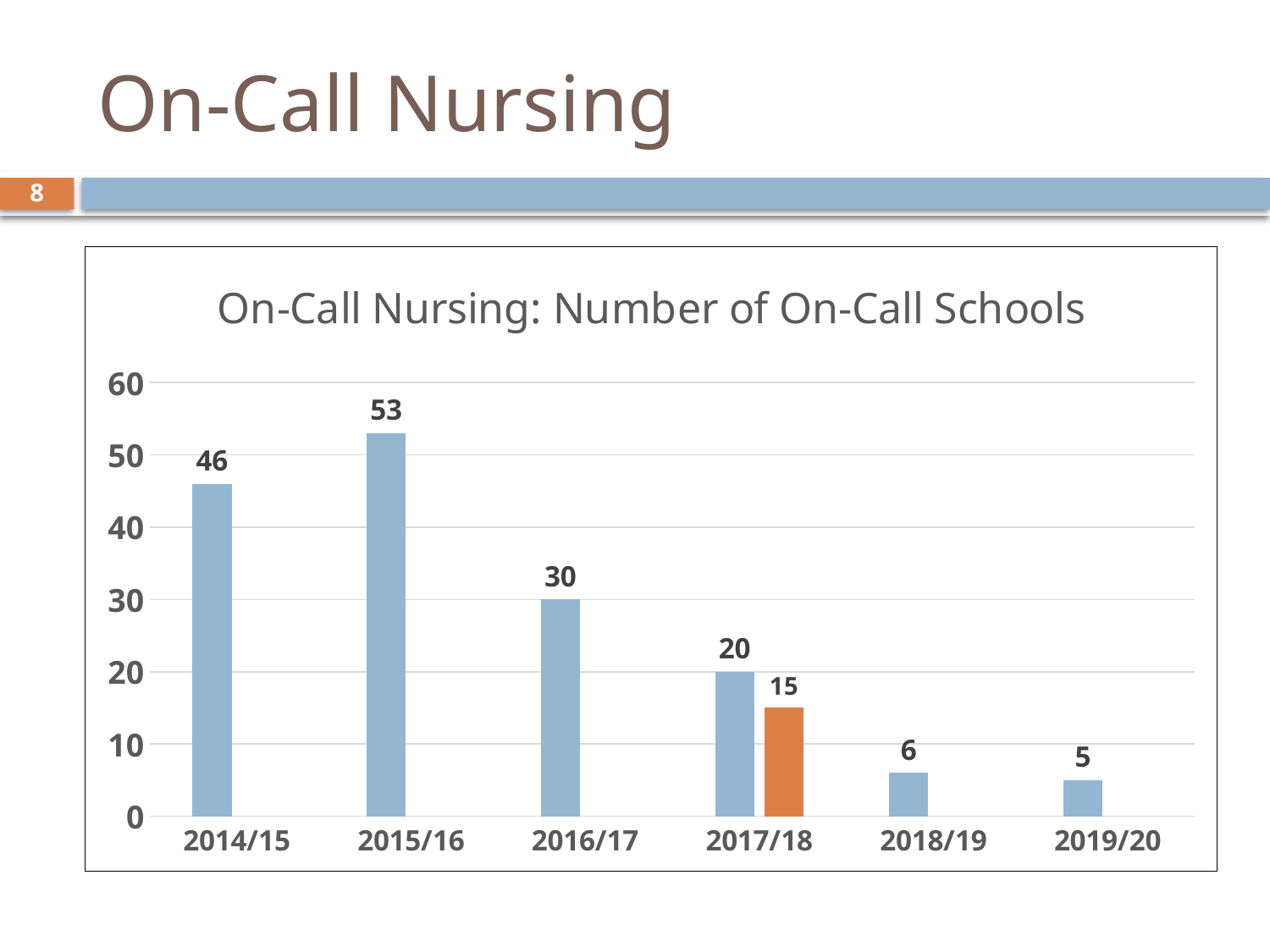
Which year has the lowest number of on-call schools? 2019/20 What is the value of the blue bar for 2019/20? 5 What is the difference between the blue bar values for 2015/16 and 2016/17? 23 What is the difference between the blue and orange bars for 2017/18? 5 How many years are shown on the x axis? 6 What is the value of the blue bar for 2014/15? 46 What is the value of the orange bar for 2017/18? 15 What kind of chart is shown on the slide? Bar chart Which year has the highest number of on-call schools? 2015/16 Which is larger, the blue bar for 2014/15 or the blue bar for 2016/17? 2014/15 What is the title of the chart? On-Call Nursing: Number of On-Call Schools What is the value of the blue bar for 2015/16? 53